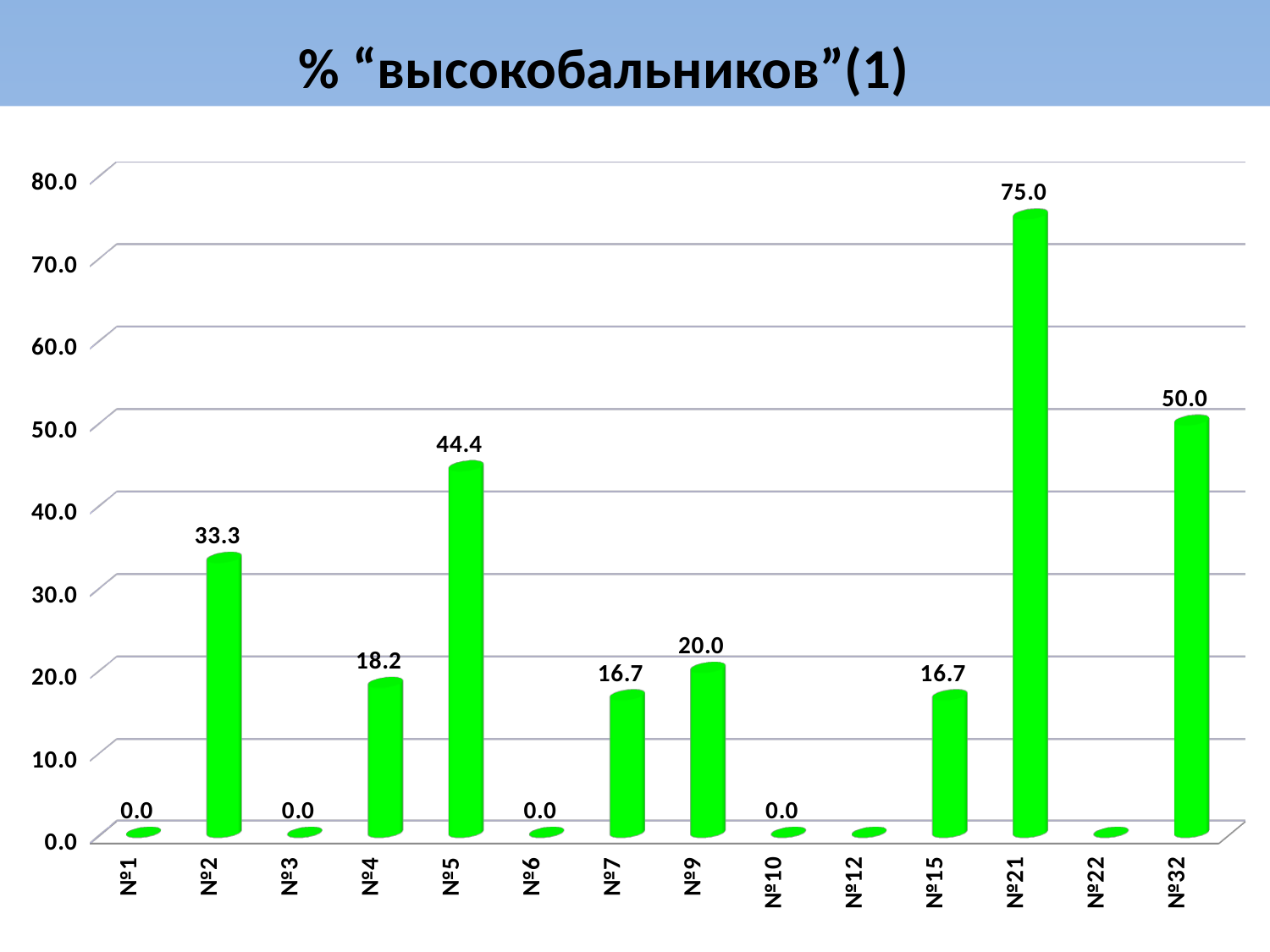
Which category has the highest value? №21 How many categories are shown on the x axis? 14 What is the difference between the values for №5 and №2? 11.1 What kind of chart is shown on the slide? bar chart Is the value for №32 greater or less than 40.0? greater Which is larger, the value for №4 or the value for №7? №4 What is the value for №9? 20.0 What is the value for №2? 33.3 What is the value for №5? 44.4 What is the value for №21? 75.0 What is the difference between the values for №21 and №32? 25.0 What is the title of the slide? % “высокобальников”(1)